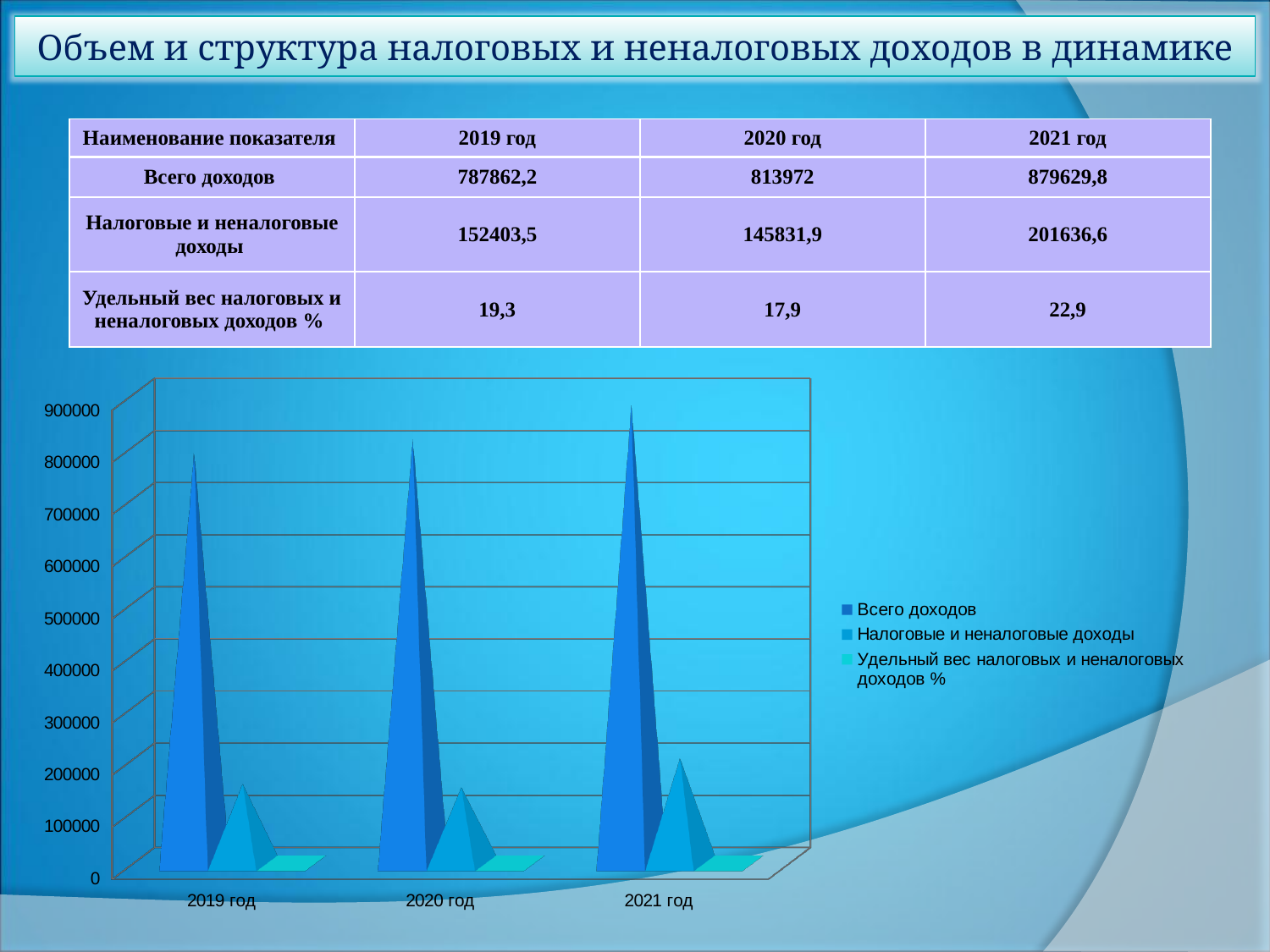
Is the value of Налоговые и неналоговые доходы for 2021 год greater or less than 100000? greater How many series does the chart legend list? 3 In which year is Налоговые и неналоговые доходы the lowest? 2020 год What kind of chart is shown on the slide? bar chart What is the difference between Всего доходов in 2021 год and 2019 год? 91767,6 What is the Удельный вес налоговых и неналоговых доходов % for 2019 год? 19,3 What is the value of Налоговые и неналоговые доходы for 2020 год? 145831,9 In which year is Всего доходов the highest? 2021 год What is the value of Всего доходов for 2021 год? 879629,8 Does Всего доходов rise or fall from 2019 год to 2021 год? rises Is the value of Всего доходов for 2019 год greater or less than 700000? greater How many year categories are shown on the x axis of the chart? 3